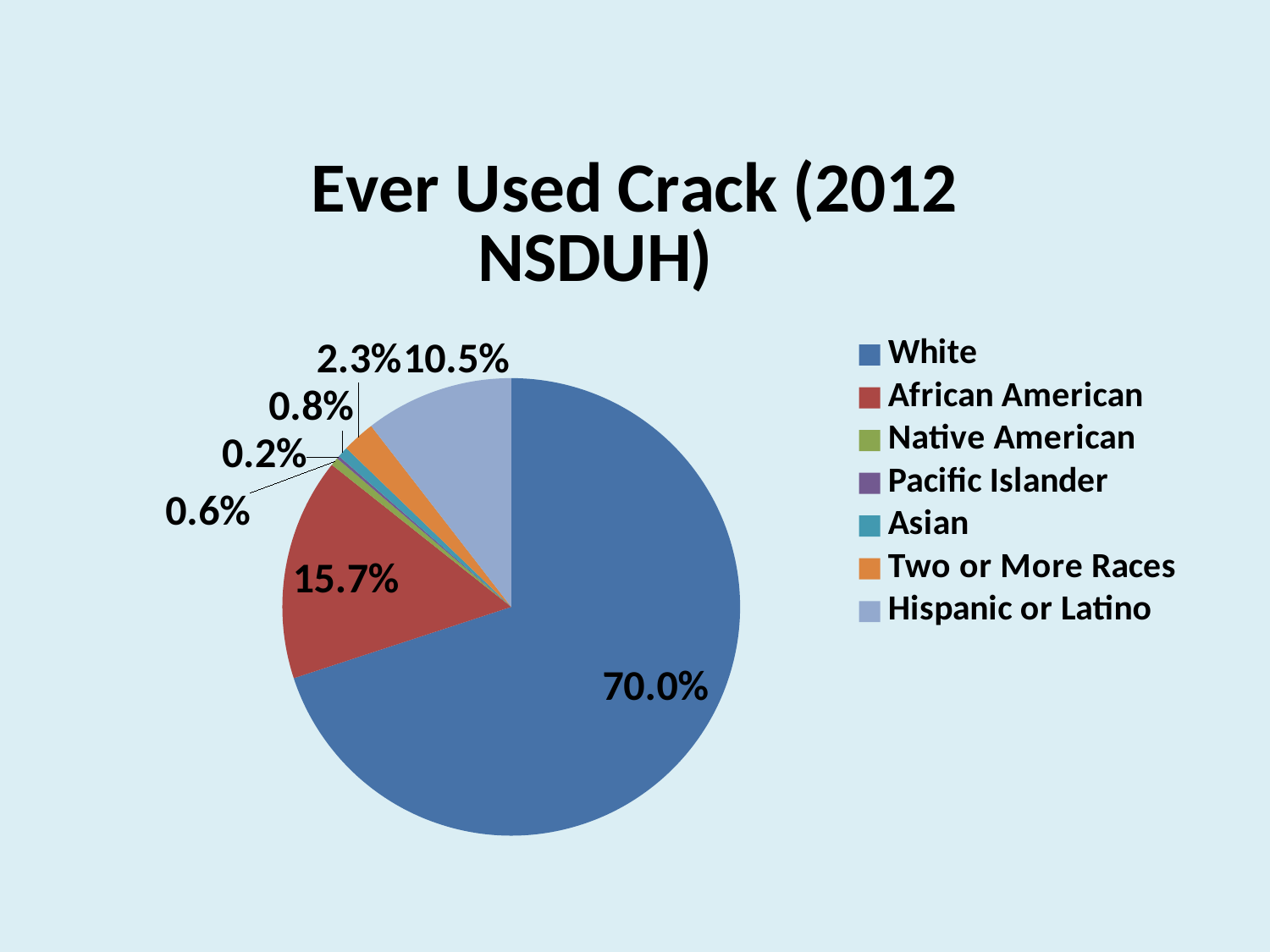
What is the title of the chart? Ever Used Crack (2012 NSDUH) What type of chart is shown on the slide? pie chart Which is larger, the Asian share or the Native American share? Asian What share of the pie is Two or More Races? 2.3% What share of the pie is Hispanic or Latino? 10.5% What share of the pie is African American? 15.7% Which category has the largest slice of the pie? White What is the difference between the White share and the African American share? 54.3% How many categories does the legend list? 7 Which category has the smallest slice of the pie? Pacific Islander